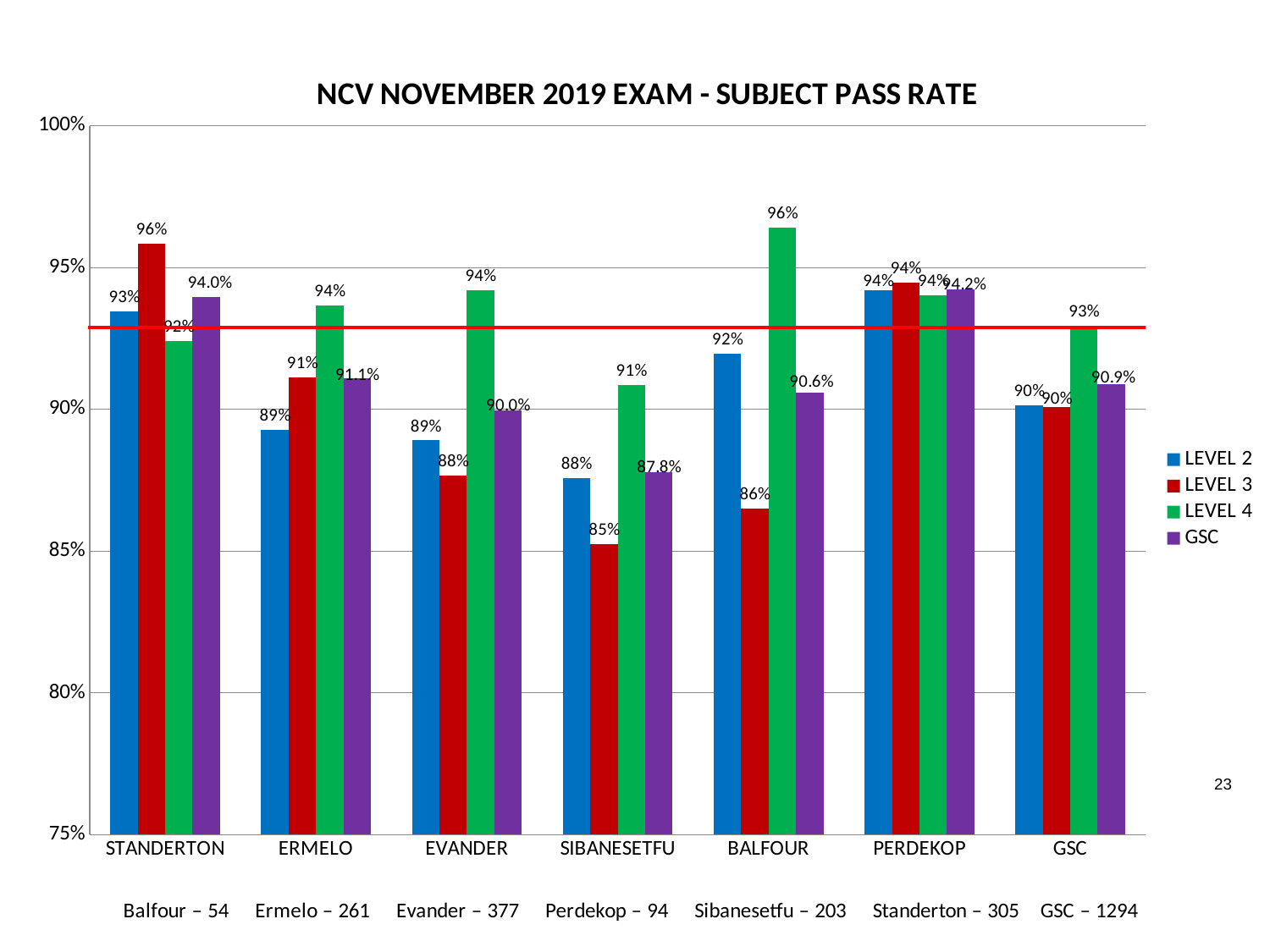
Which is larger: the LEVEL 4 pass rate for ERMELO or the LEVEL 2 pass rate for EVANDER? LEVEL 4 pass rate for ERMELO How many series does the legend list? 4 How many campuses are shown on the x axis? 7 Which campus has the lowest LEVEL 3 pass rate? SIBANESETFU What is the LEVEL 4 pass rate for BALFOUR? 96% Is the LEVEL 3 value for BALFOUR greater or less than 90%? less What is the difference between the LEVEL 3 and LEVEL 2 pass rates for STANDERTON? 3 percentage points What is the LEVEL 3 pass rate for STANDERTON? 96% Which campus has the highest LEVEL 4 pass rate? BALFOUR What is the GSC value for SIBANESETFU? 87.8% What kind of chart is shown on the slide? Bar chart What is the GSC value for PERDEKOP? 94.2%